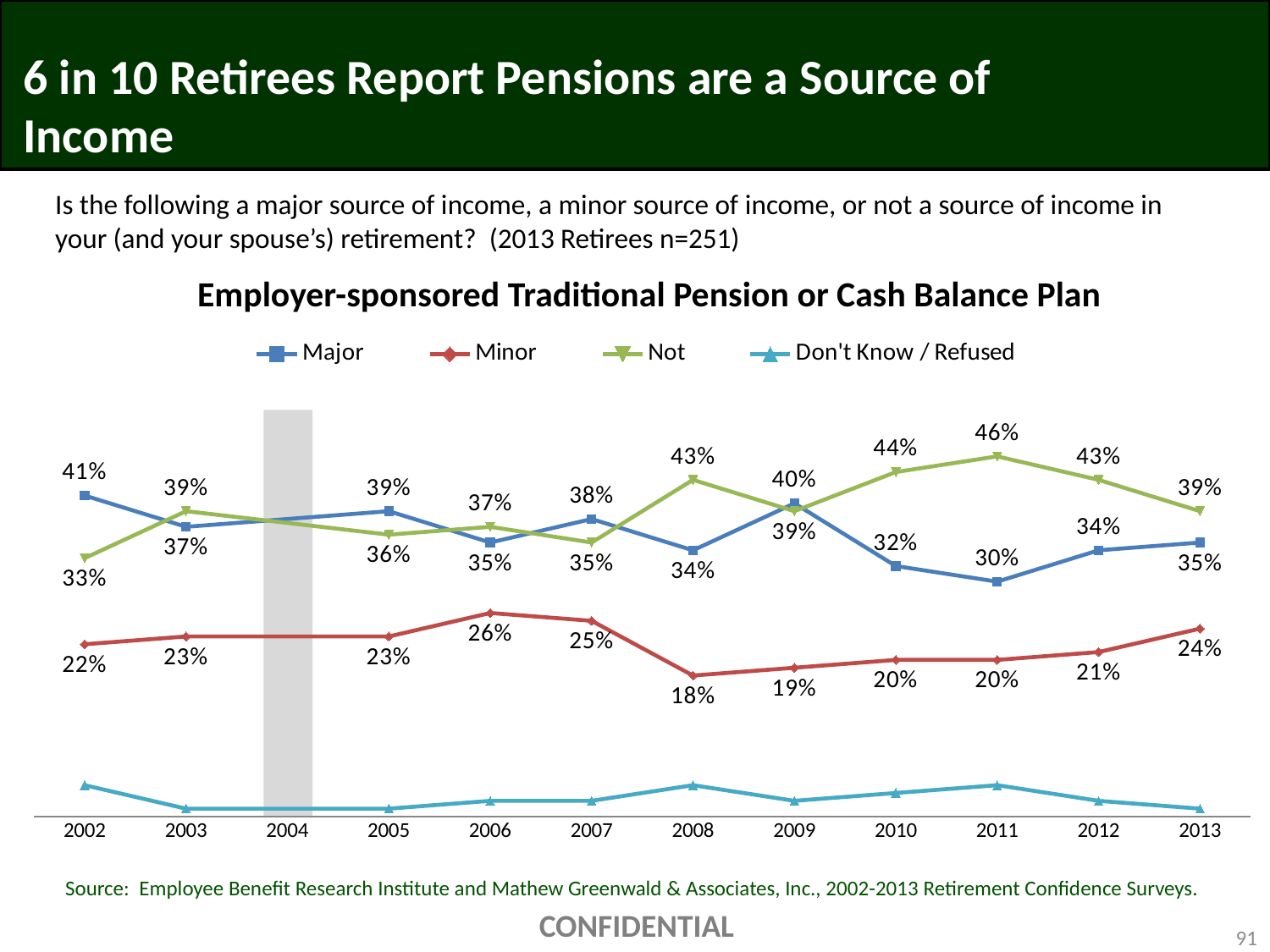
Does the Minor series rise or fall from 2008 to 2013? Rise How many series does the legend list? 4 In which year does the Not series reach its highest value? 2011 What is the title of the chart? Employer-sponsored Traditional Pension or Cash Balance Plan What is the value for Minor in 2008? 18% What is the value for Major in 2002? 41% What is the value for Not in 2011? 46% In which year is the Major series at its lowest value? 2011 What is the difference between the Not value and the Major value in 2011? 16 percentage points In 2013, which is larger: the Not value or the Major value? Not How many years are shown on the x axis? 12 What kind of chart is shown on the slide? Line chart